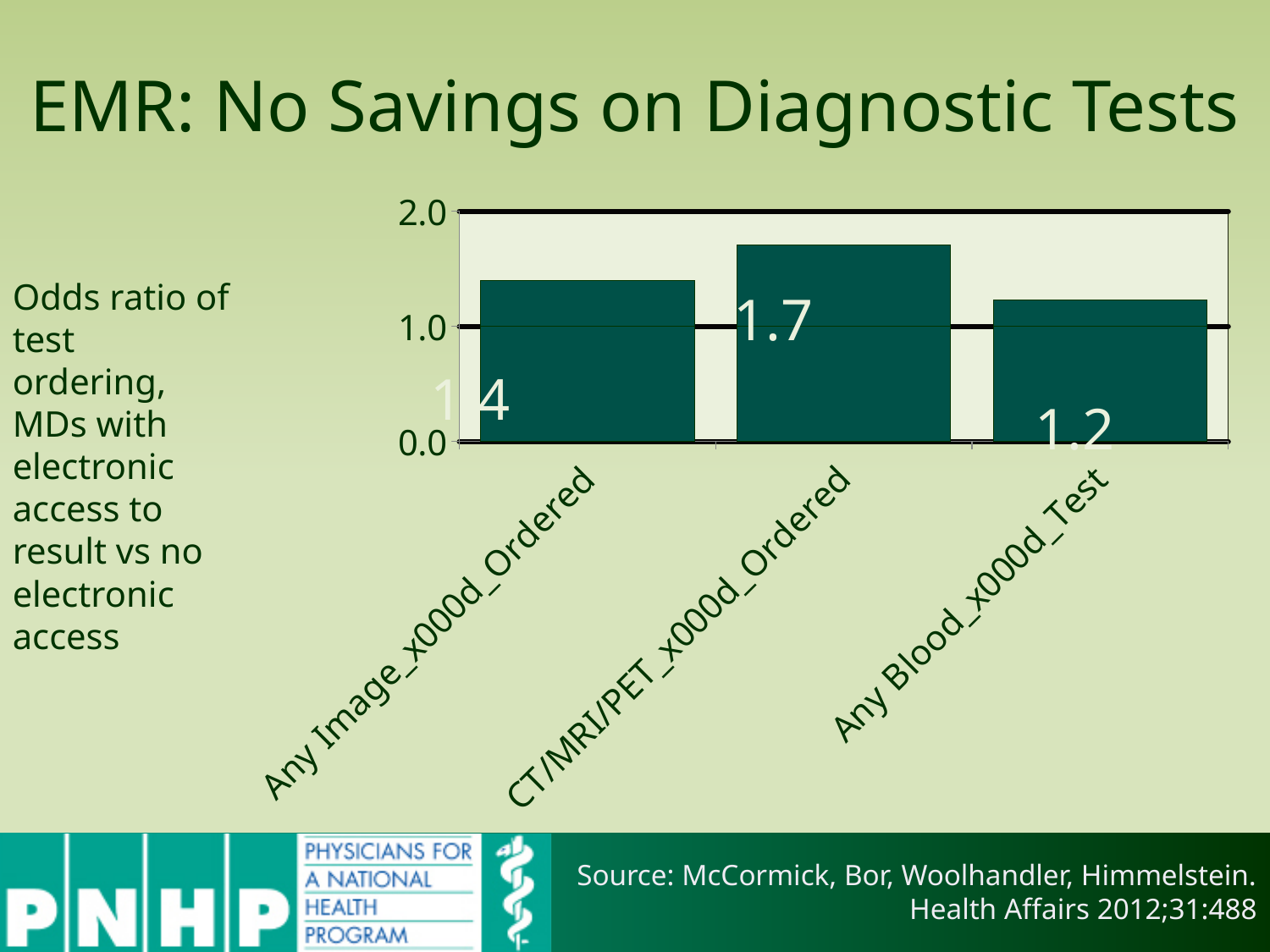
Is the value for Any Blood Test greater or less than 1.0? greater What is the odds ratio shown for CT/MRI/PET Ordered? 1.7 What type of chart is shown on the slide? bar chart What is the difference between the odds ratios for CT/MRI/PET Ordered and Any Blood Test? 0.5 Is the value for CT/MRI/PET Ordered greater or less than 2.0? less Which category has the lowest odds ratio? Any Blood Test How many bars (categories) does the chart show? 3 What is the odds ratio shown for Any Blood Test? 1.2 Which category has the highest odds ratio? CT/MRI/PET Ordered What is the odds ratio shown for Any Image Ordered? 1.4 What is the title of the slide containing the chart? EMR: No Savings on Diagnostic Tests Which is larger, the odds ratio for Any Image Ordered or for Any Blood Test? Any Image Ordered